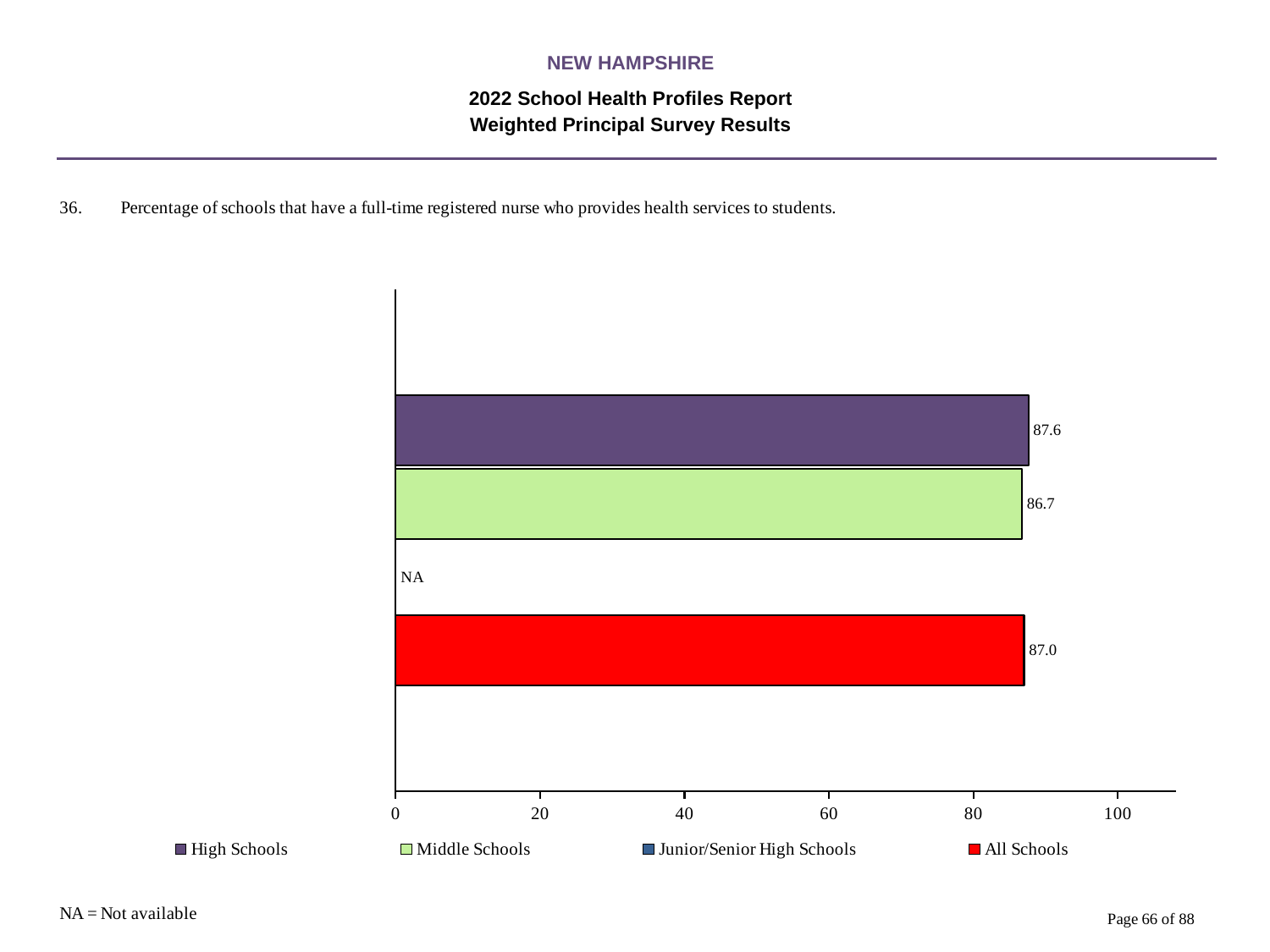
Is the value for All Schools greater or less than 80? greater What kind of chart is shown? bar chart What is the value for Middle Schools? 86.7 Which series with a plotted value has the lowest value? Middle Schools What does NA stand for according to the note on the slide? Not available What is the value for High Schools? 87.6 What is the difference between the High Schools value and the Middle Schools value? 0.9 What is the difference between the All Schools value and the Middle Schools value? 0.3 How many series does the legend list? 4 Which series has the highest value? High Schools What is the value for All Schools? 87.0 What is shown for Junior/Senior High Schools? NA